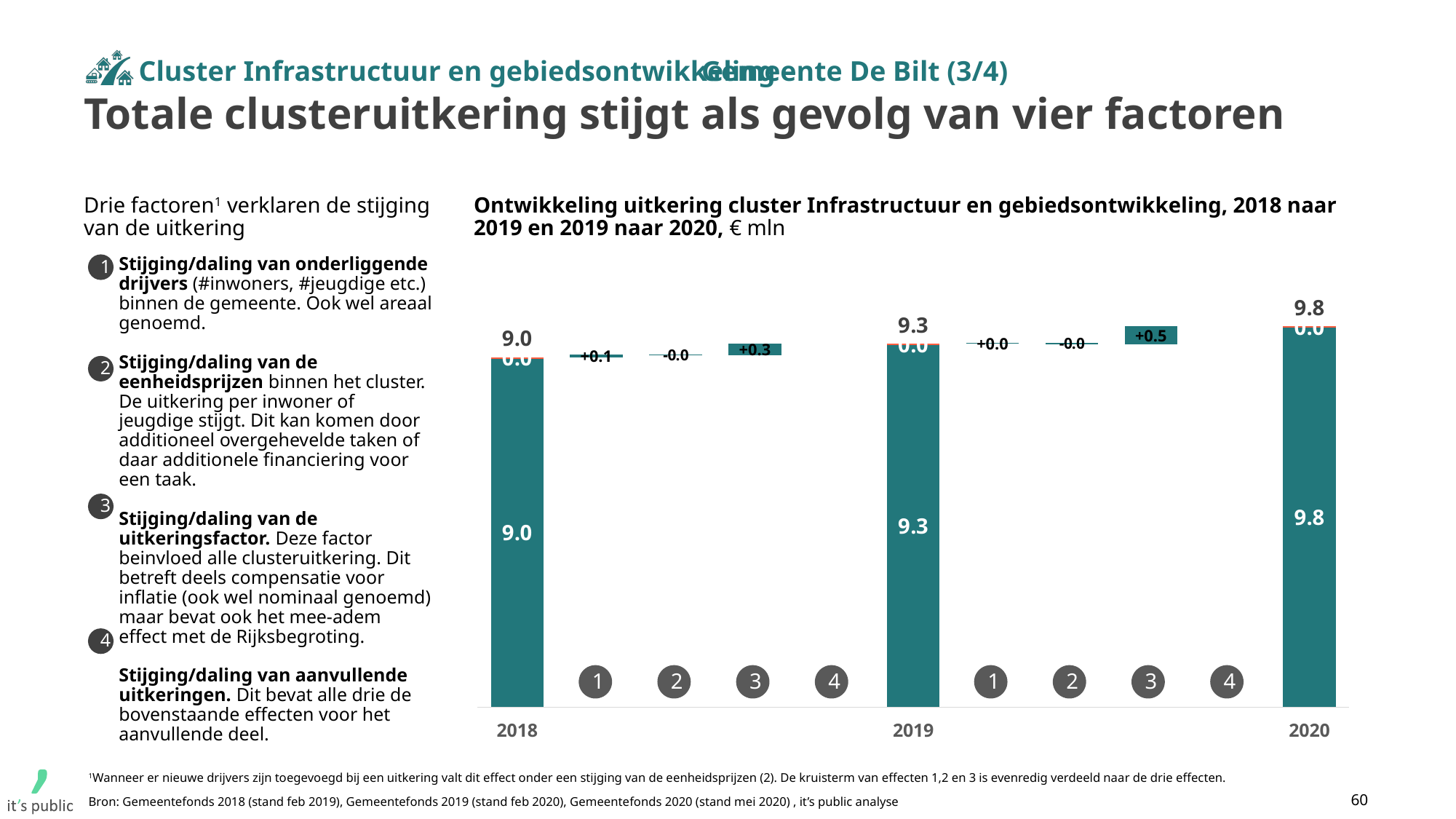
What is the total cluster payout shown for 2018? 9.0 What is the value of factor 3 (uitkeringsfactor) in the step from 2019 to 2020? +0.5 Is the total for 2019 larger or smaller than the total for 2020? smaller Which year has the highest total cluster payout? 2020 Do the total values rise or fall from 2018 to 2020? rise Which year has the lowest total cluster payout? 2018 What is the value of factor 1 in the step from 2018 to 2019? +0.1 What is the difference between the 2020 total and the 2018 total? 0.8 In what unit are the values in the chart expressed? € mln What is the value of factor 3 (uitkeringsfactor) in the step from 2018 to 2019? +0.3 What is the total cluster payout shown for 2020? 9.8 What is the total cluster payout shown for 2019? 9.3